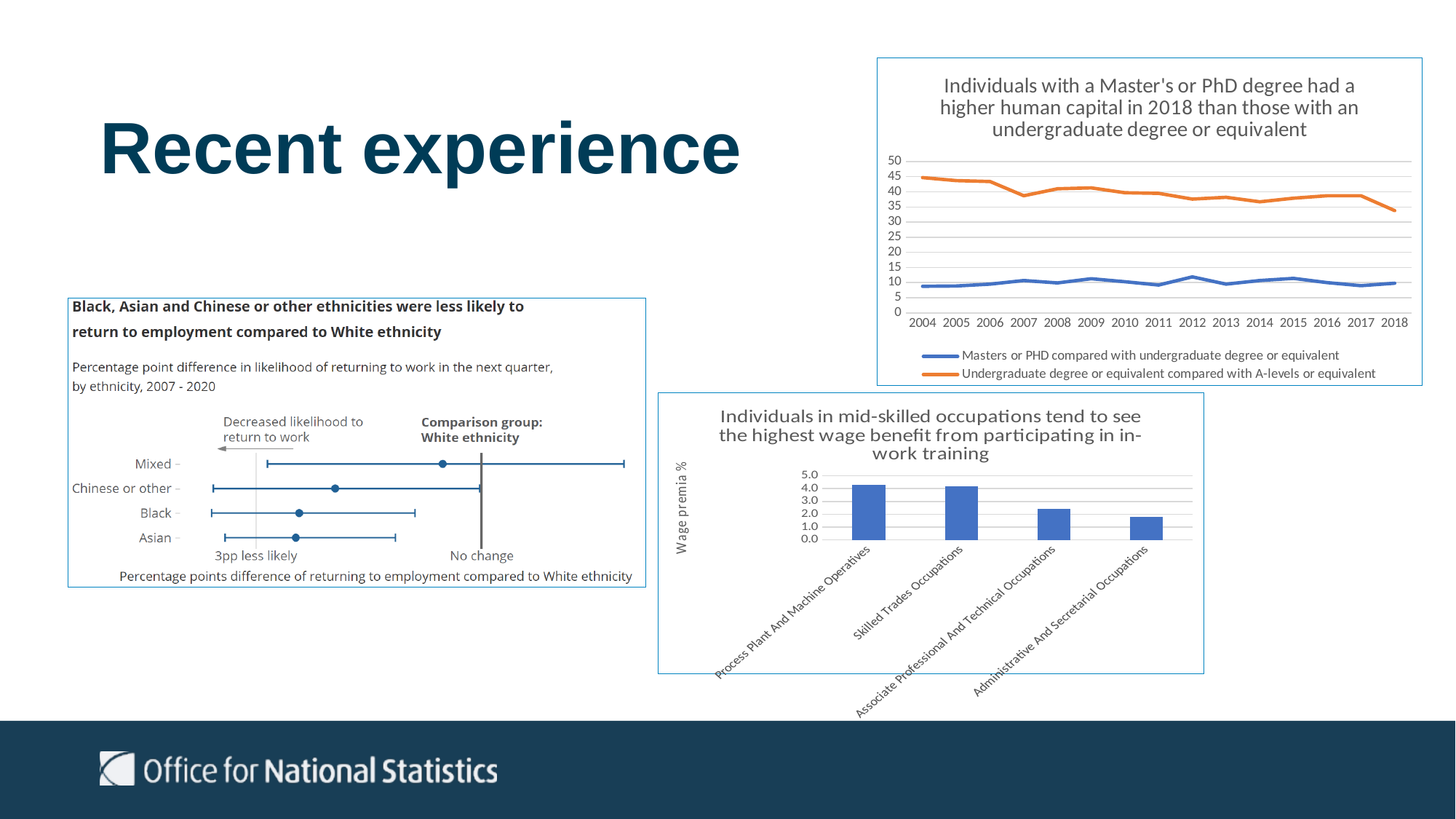
In the chart titled 'Individuals in mid-skilled occupations tend to see the highest wage benefit...', is the value for Administrative And Secretarial Occupations greater or less than 2.0? less In the chart titled 'Individuals with a Master's or PhD degree had a higher human capital in 2018...', how many years are shown on the x axis? 15 In the chart titled 'Individuals with a Master's or PhD degree had a higher human capital in 2018...', is the 2004 value for 'Undergraduate degree or equivalent compared with A-levels or equivalent' greater or less than 40? greater In the chart titled 'Individuals with a Master's or PhD degree had a higher human capital in 2018...', how many series does the legend list? 2 In the chart titled 'Individuals in mid-skilled occupations tend to see the highest wage benefit...', which is larger: Associate Professional And Technical Occupations or Administrative And Secretarial Occupations? Associate Professional And Technical Occupations In the chart titled 'Individuals with a Master's or PhD degree had a higher human capital in 2018...', is the 2004 value for 'Masters or PHD compared with undergraduate degree or equivalent' greater or less than 10? less In the chart titled 'Individuals with a Master's or PhD degree had a higher human capital in 2018...', which series has the higher value in 2018? Undergraduate degree or equivalent compared with A-levels or equivalent In the chart titled 'Individuals in mid-skilled occupations tend to see the highest wage benefit...', how many occupation categories are shown? 4 In the chart titled 'Individuals in mid-skilled occupations tend to see the highest wage benefit...', which occupation has the lowest wage premia? Administrative And Secretarial Occupations In the chart titled 'Individuals with a Master's or PhD degree had a higher human capital in 2018...', does the 'Undergraduate degree or equivalent compared with A-levels or equivalent' series generally rise or fall from 2004 to 2018? fall What kind of chart is the one titled 'Individuals in mid-skilled occupations tend to see the highest wage benefit from participating in in-work training'? bar chart In the chart titled 'Black, Asian and Chinese or other ethnicities were less likely to return to employment...', how many ethnicity categories are plotted? 4